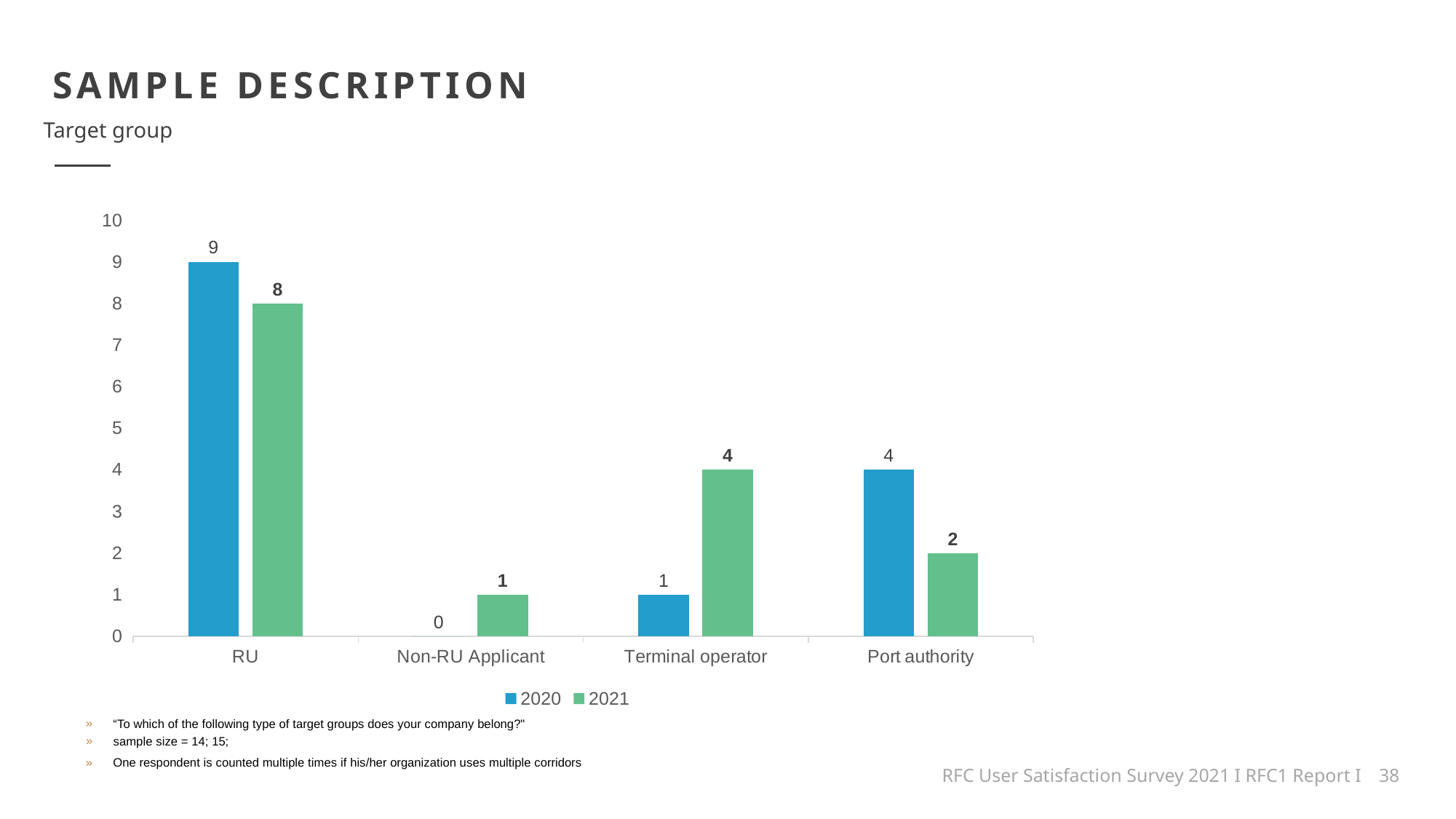
Which series is shown in green in the legend? 2021 Which is larger for Terminal operator, the 2020 value or the 2021 value? 2021 What is the difference between the 2020 and 2021 values for Port authority? 2 What is the 2020 value for Non-RU Applicant? 0 What is the 2021 value for Terminal operator? 4 How many categories are shown on the x axis? 4 What is the 2020 value for RU? 9 Which category has the highest 2021 value? RU What is the 2021 value for Port authority? 2 Which category has the lowest 2020 value? Non-RU Applicant What kind of chart is shown on the slide? Bar chart How many series does the legend list? 2